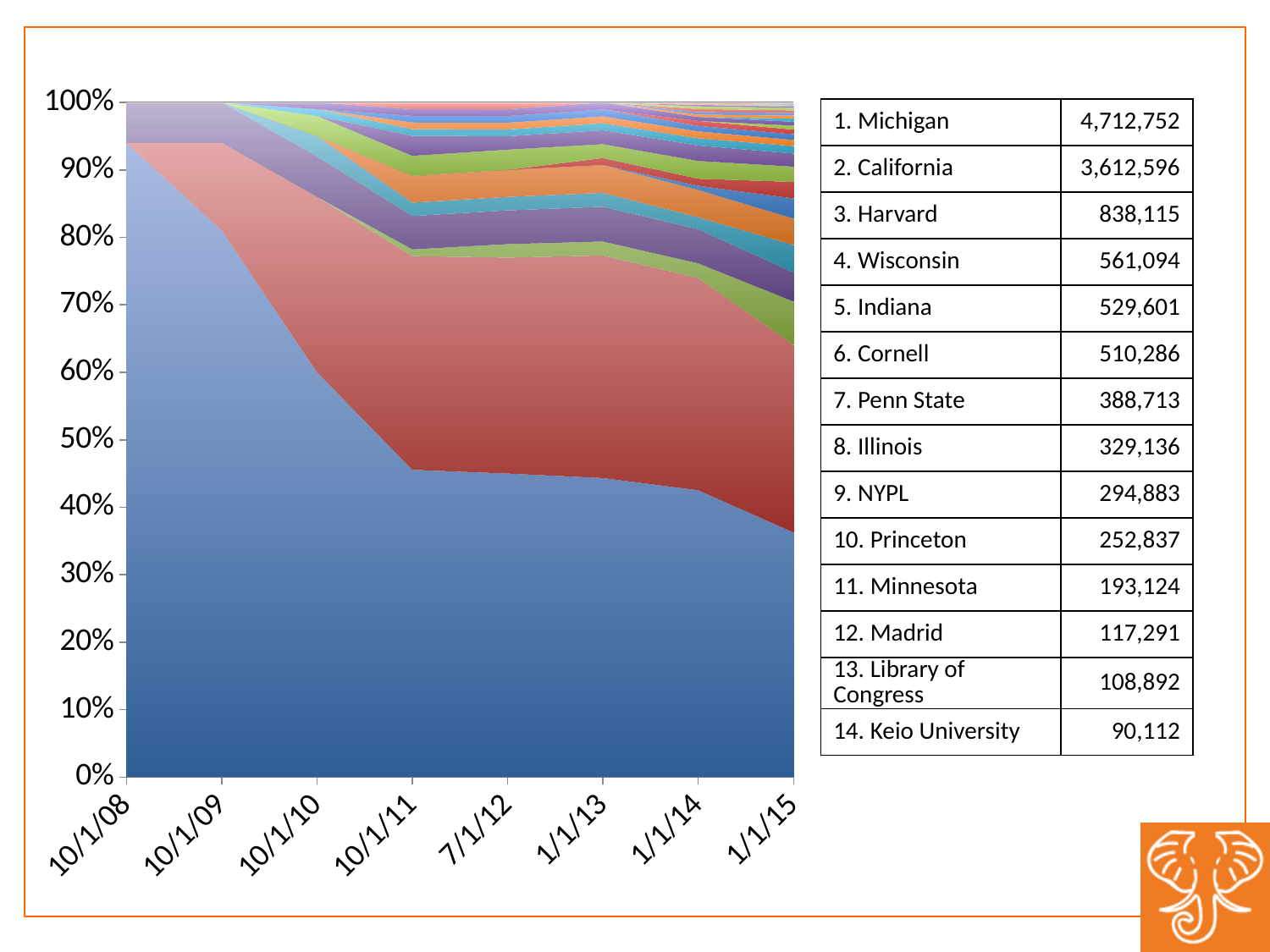
Is the share of the bottom blue area at 10/1/08 greater or less than 90%? greater What kind of chart is shown on the slide? Stacked area chart How many dates are labelled along the x axis of the chart? 8 What is the first date labelled on the x axis of the chart? 10/1/08 At which labelled date is the share of the bottom blue area the largest? 10/1/08 At which labelled date is the share of the bottom blue area the smallest? 1/1/15 What is the highest value shown on the y axis of the chart? 100% Is the share of the bottom blue area at 1/1/15 greater or less than 40%? less Is the share of the bottom blue area at 10/1/10 greater or less than 50%? greater Does the share of the bottom blue area rise or fall from 10/1/08 to 1/1/15? Fall What is the last date labelled on the x axis of the chart? 1/1/15